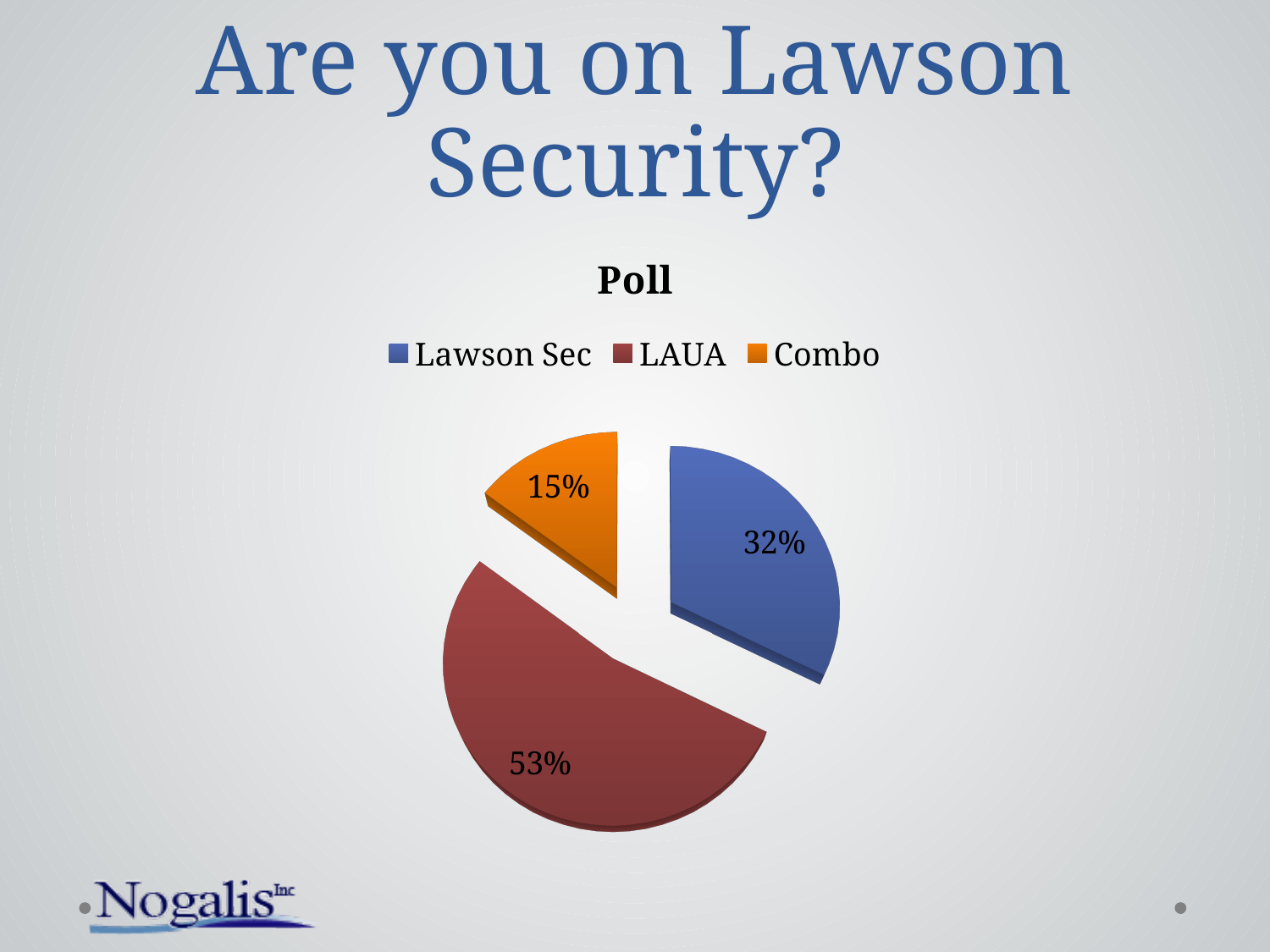
What is the difference in percentage points between Lawson Sec and Combo? 17 Which colour represents LAUA in the legend? Red What share of the pie does LAUA have? 53% What kind of chart is shown on the slide? Pie chart Which category has the smallest slice of the pie? Combo What is the title of the chart? Poll How many categories does the pie chart have? 3 What share of the pie does Lawson Sec have? 32% What share of the pie does Combo have? 15% Which category has the largest slice of the pie? LAUA Which is larger, the share for Lawson Sec or the share for Combo? Lawson Sec What is the difference in percentage points between LAUA and Lawson Sec? 21